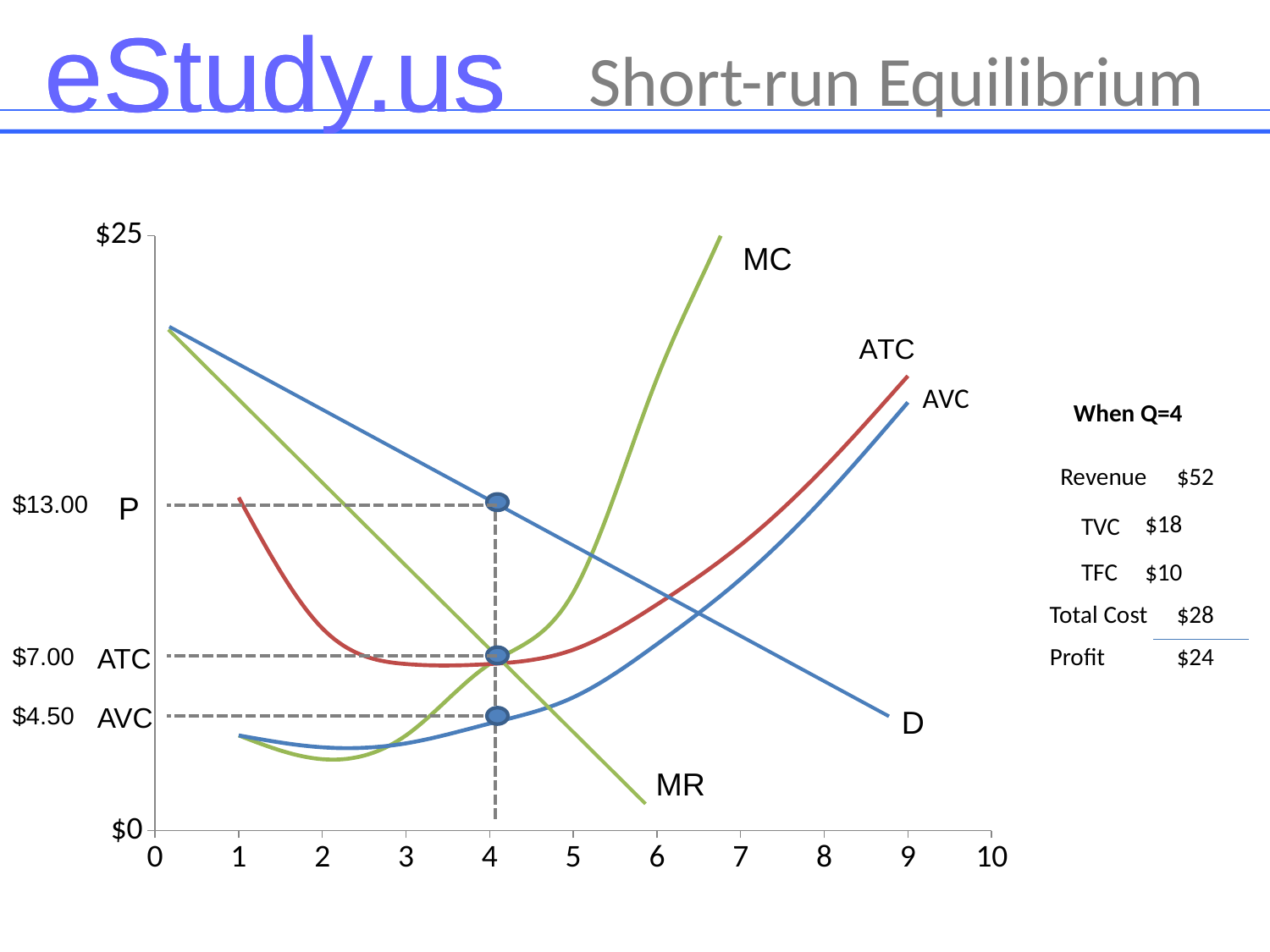
At Q=4, which is larger, ATC or AVC? ATC What is the AVC value at Q=4 shown on the chart? $4.50 Is the value of the demand curve (D) at Q=8 greater or less than $13? less What is the highest value shown on the y axis of the chart? $25 Does the demand curve (D) rise or fall as quantity increases? fall How many labelled curves are plotted on the chart? 5 What is the difference between ATC and AVC at Q=4? $2.50 What is the difference between the price and ATC at Q=4? $6.00 What kind of chart is shown on the slide? line chart What is the price (P) at Q=4 shown on the chart? $13.00 What is the ATC value at Q=4 shown on the chart? $7.00 What is the title of the slide containing the chart? Short-run Equilibrium